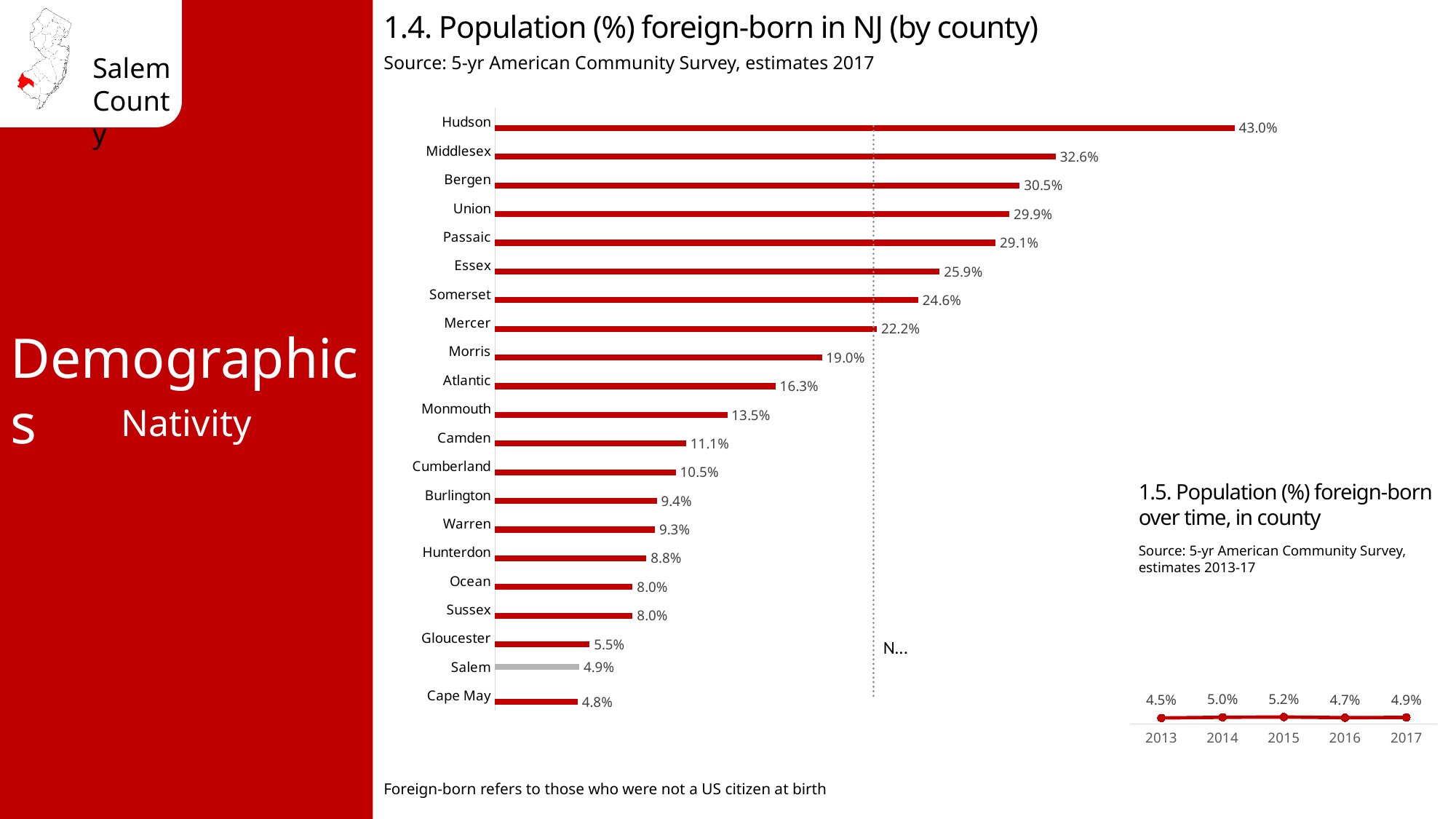
In the chart '1.5. Population (%) foreign-born over time, in county', what is the value for 2015? 5.2% In the chart '1.4. Population (%) foreign-born in NJ (by county)', which county has the lowest value? Cape May In the chart '1.4. Population (%) foreign-born in NJ (by county)', how many counties are shown? 21 In the chart '1.5. Population (%) foreign-born over time, in county', which year has the lowest value? 2013 In the chart '1.4. Population (%) foreign-born in NJ (by county)', which county has the highest value? Hudson In the chart '1.4. Population (%) foreign-born in NJ (by county)', what is the value for Hudson? 43.0% In the chart '1.4. Population (%) foreign-born in NJ (by county)', which county's bar is coloured grey instead of red? Salem In the chart '1.4. Population (%) foreign-born in NJ (by county)', what is the difference between Hudson and Salem? 38.1% In the chart '1.5. Population (%) foreign-born over time, in county', how many years are plotted? 5 In the chart '1.4. Population (%) foreign-born in NJ (by county)', what is the value for Salem? 4.9% What kind of chart is '1.4. Population (%) foreign-born in NJ (by county)'? Bar chart In the chart '1.4. Population (%) foreign-born in NJ (by county)', which is larger, Bergen or Union? Bergen